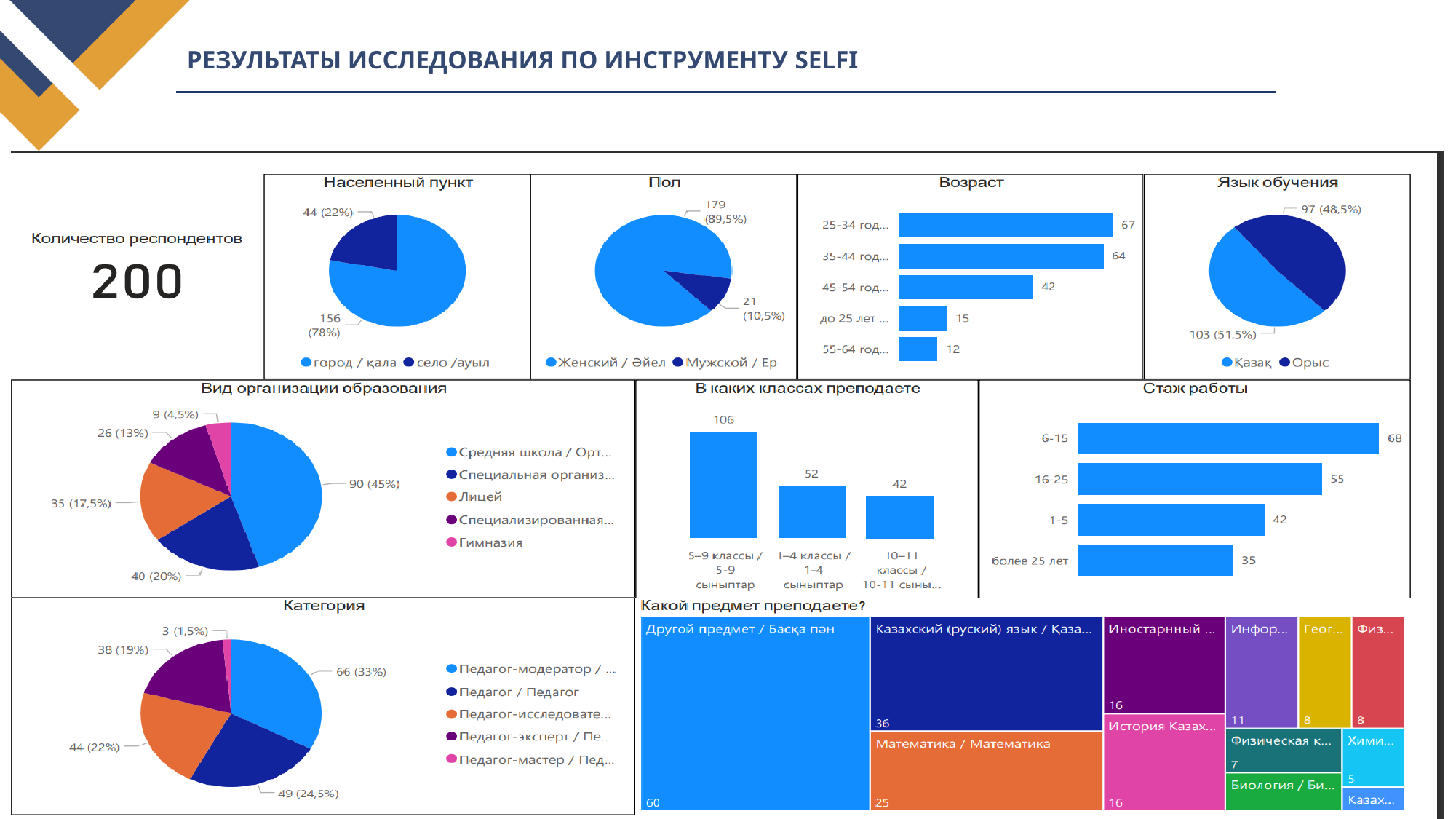
In the 'Какой предмет преподаете?' chart, what is the value for 'Математика / Математика'? 25 In the 'Возраст' chart, what is the value for the 25-34 age group? 67 In the 'Стаж работы' chart, what is the value for '16-25'? 55 In the 'Населенный пункт' pie chart, what is the value for 'село /ауыл'? 44 (22%) In the 'Пол' pie chart, what share does 'Мужской / Ер' have? 10,5% In the 'Возраст' chart, which age group has the lowest value? 55-64 In the 'Стаж работы' chart, what is the difference between the values for '6-15' and 'более 25 лет'? 33 How many entries does the legend of the 'Вид организации образования' chart list? 5 In the 'Категория' pie chart, what is the value for 'Педагог-модератор'? 66 (33%) In the 'Язык обучения' pie chart, which is larger: 'Қазақ' or 'Орыс'? Қазақ In the 'В каких классах преподаете' chart, how many bars are shown? 3 In the 'В каких классах преподаете' chart, which category has the highest value? 5–9 классы / 5-9 сыныптар